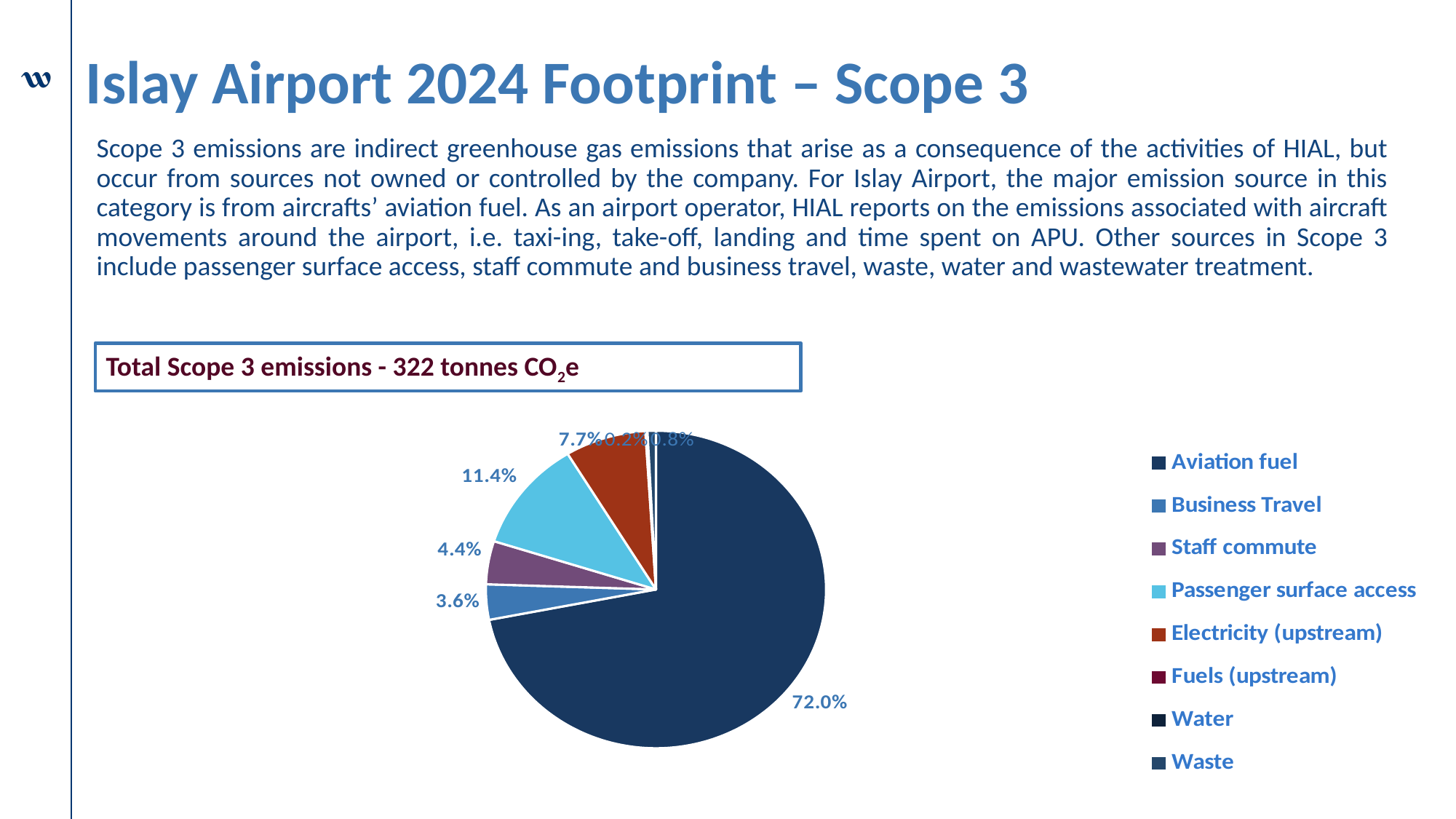
What is the difference in percentage points between the Passenger surface access share and the Electricity (upstream) share? 3.7 Which is larger, the share for Electricity (upstream) or the share for Passenger surface access? Passenger surface access How many categories does the legend of the pie chart list? 8 What share of Scope 3 emissions comes from Staff commute? 4.4% What share of Scope 3 emissions comes from Passenger surface access? 11.4% What kind of chart is shown on the slide? pie chart What share of Scope 3 emissions comes from Aviation fuel? 72.0% Which category accounts for the largest share of the pie? Aviation fuel What is the total Scope 3 emissions figure stated above the chart? 322 tonnes CO2e What share of Scope 3 emissions comes from Business Travel? 3.6% What share of Scope 3 emissions comes from Electricity (upstream)? 7.7% Which is larger, the share for Staff commute or the share for Business Travel? Staff commute